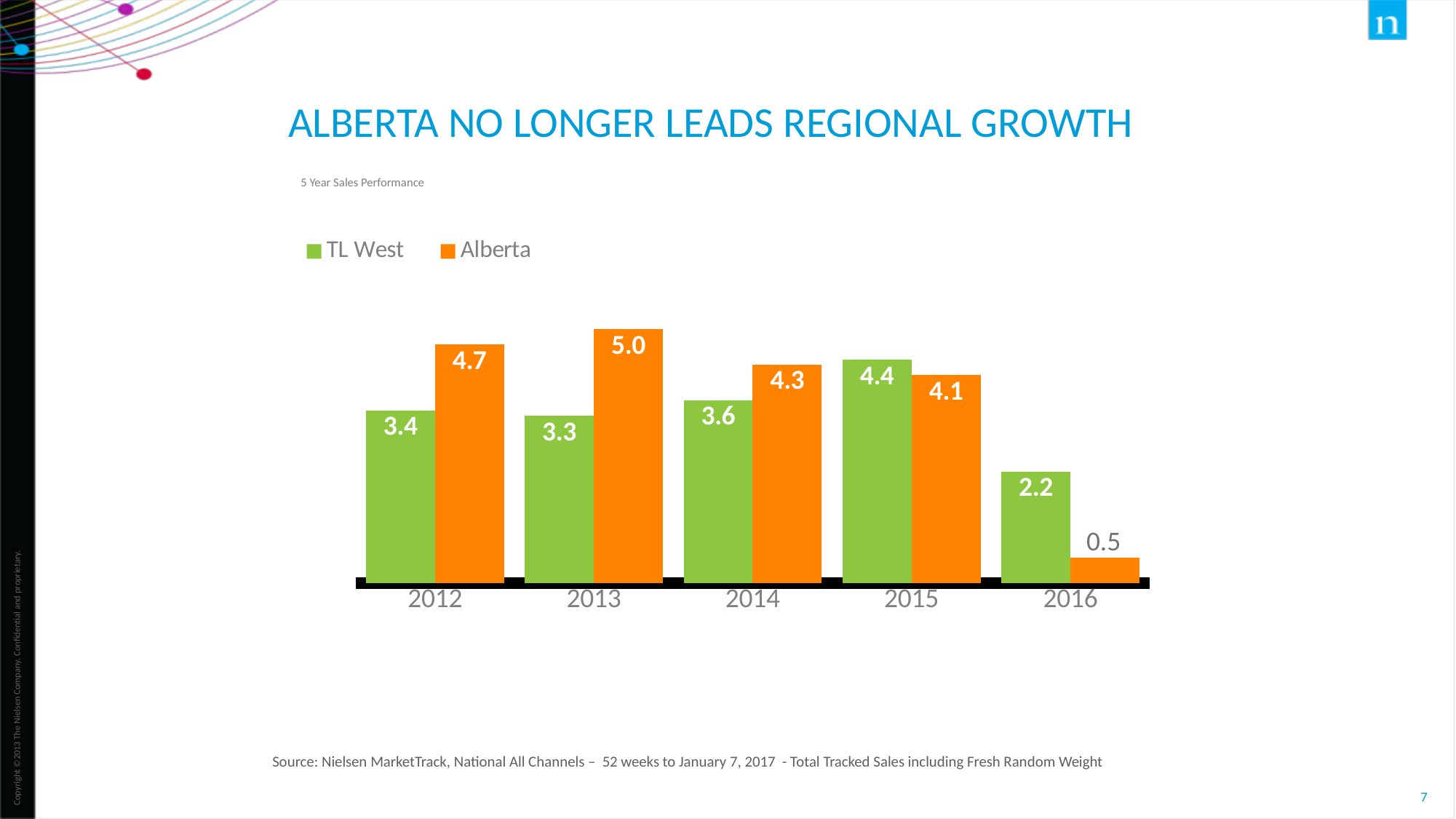
What kind of chart is shown on the slide? Bar chart Which colour represents Alberta in the chart? Orange What is the value for TL West in 2016? 2.2 How many years are shown on the x axis? 5 Do the Alberta values rise or fall from 2013 to 2016? Fall Which is larger in 2015, TL West or Alberta? TL West What is the difference between the Alberta and TL West values in 2012? 1.3 What is the value for Alberta in 2016? 0.5 What is the value for Alberta in 2013? 5.0 In which year is the Alberta value highest? 2013 In which year is the TL West value lowest? 2016 How many series does the legend list? 2